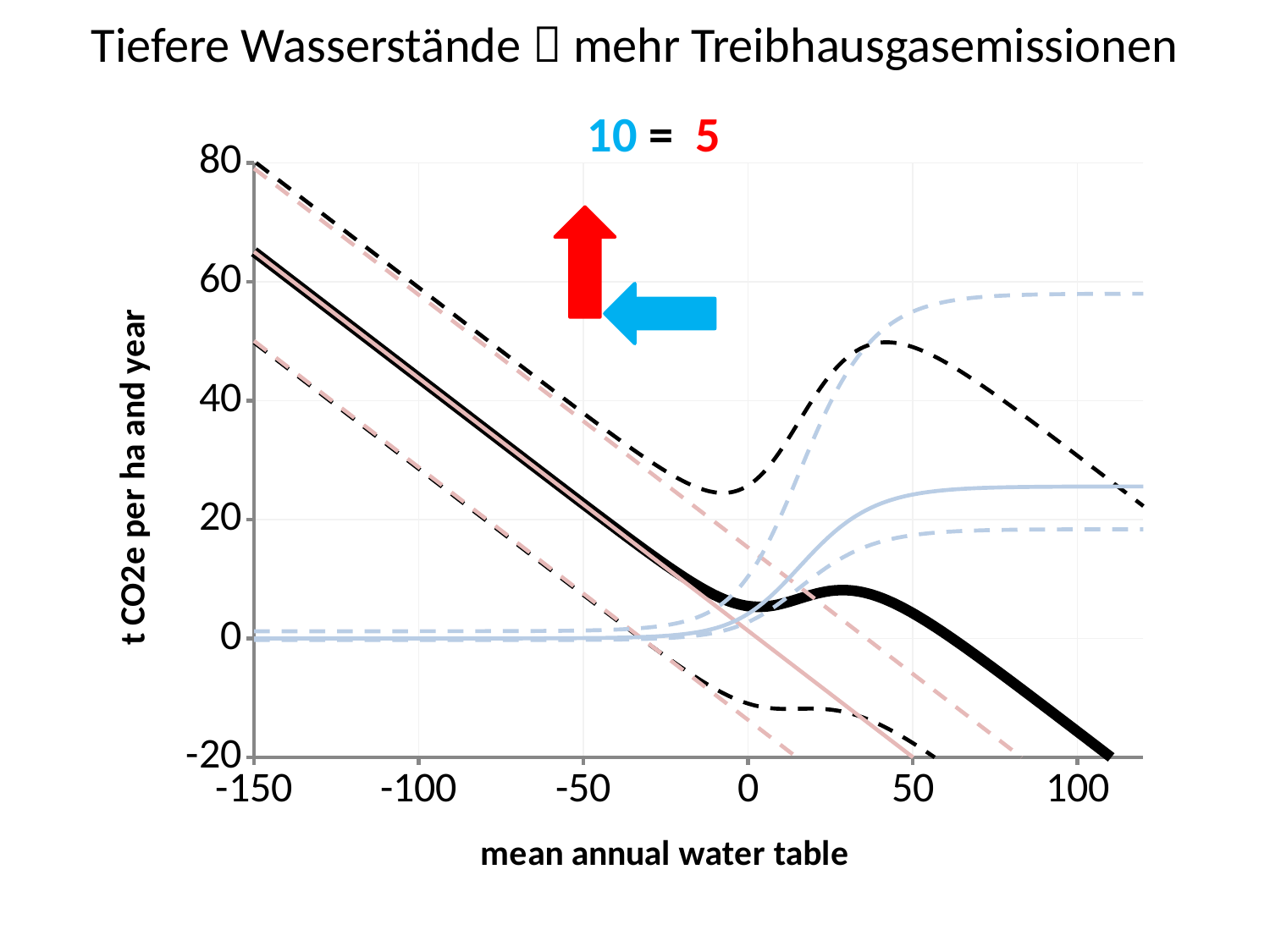
Is the value of the solid light blue line at a mean annual water table of -100 greater or less than 20? less Does the thick black line rise or fall as the mean annual water table goes from -150 to 0? fall Is the value of the solid pink line at a mean annual water table of 50 greater or less than 0? less What is the label of the y axis? t CO2e per ha and year Does the solid light blue line rise or fall as the mean annual water table goes from 0 to 50? rise Is the value of the solid light blue line at a mean annual water table of 100 greater or less than 20? greater What is the label of the x axis? mean annual water table At a mean annual water table of -100, which is larger: the thick black line or the solid light blue line? the thick black line At a mean annual water table of 100, which is larger: the solid light blue line or the thick black line? the solid light blue line What kind of chart is shown on the slide? line chart